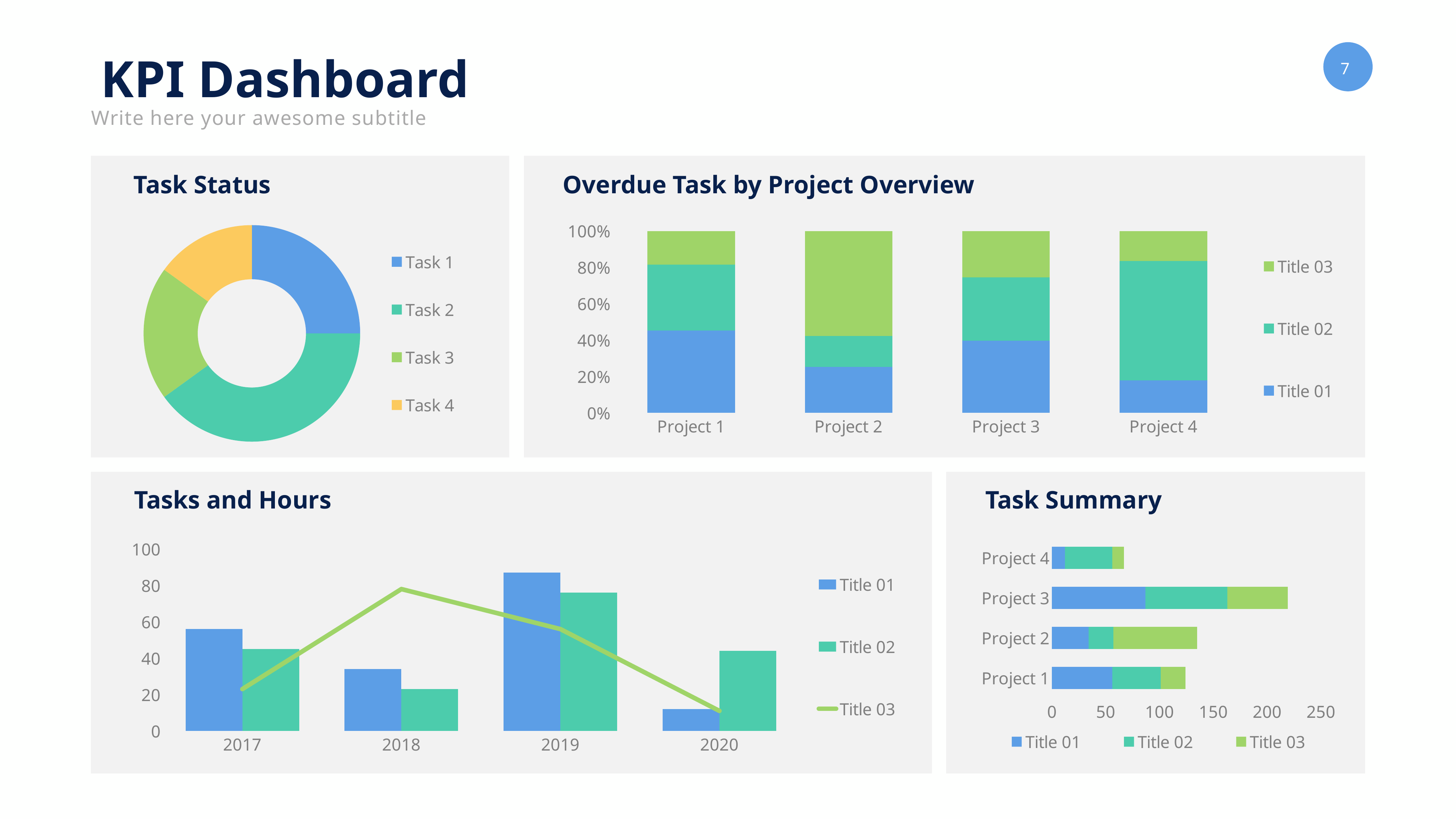
In the Task Summary chart, is the total for Project 4 greater or less than 100? less In the Overdue Task by Project Overview chart, which project has the largest Title 02 share? Project 4 In the Tasks and Hours chart, is the Title 01 value for 2017 greater or less than 50? greater What kind of chart is the Task Status chart? donut (pie) chart In the Task Status chart, which task has the largest slice? Task 2 In the Task Summary chart, which project has the longest total bar? Project 3 In the Overdue Task by Project Overview chart, is the Title 03 share for Project 2 greater or less than 50%? greater How many series does the legend of the Overdue Task by Project Overview chart list? 3 In the Task Status chart, which task has the smallest slice? Task 4 In the Overdue Task by Project Overview chart, which project has the smallest Title 01 share? Project 4 In the Tasks and Hours chart, does the Title 03 line rise or fall from 2019 to 2020? fall